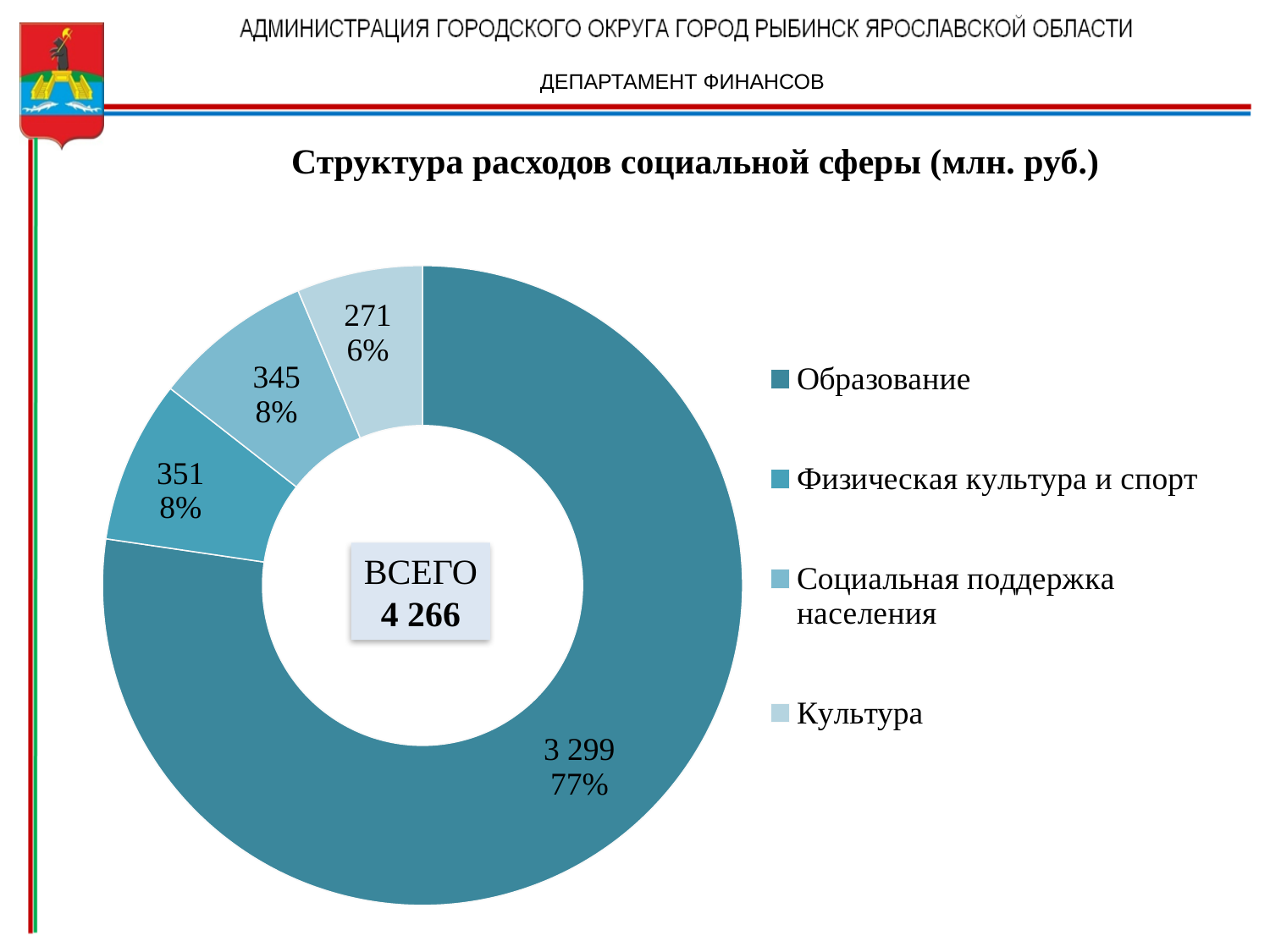
What is the value for Культура? 271 Which category has the largest share of expenditure? Образование What share of the total does Культура account for? 6% What share of the total does Образование account for? 77% Which category has the smallest share of expenditure? Культура What is the value for Социальная поддержка населения? 345 What type of chart is shown on the slide? Doughnut (pie) chart What is the difference between the values for Физическая культура и спорт and Социальная поддержка населения? 6 How many categories does the chart show? 4 What total (ВСЕГО) is shown in the centre of the chart? 4 266 What is the value for Образование? 3 299 What is the value for Физическая культура и спорт? 351